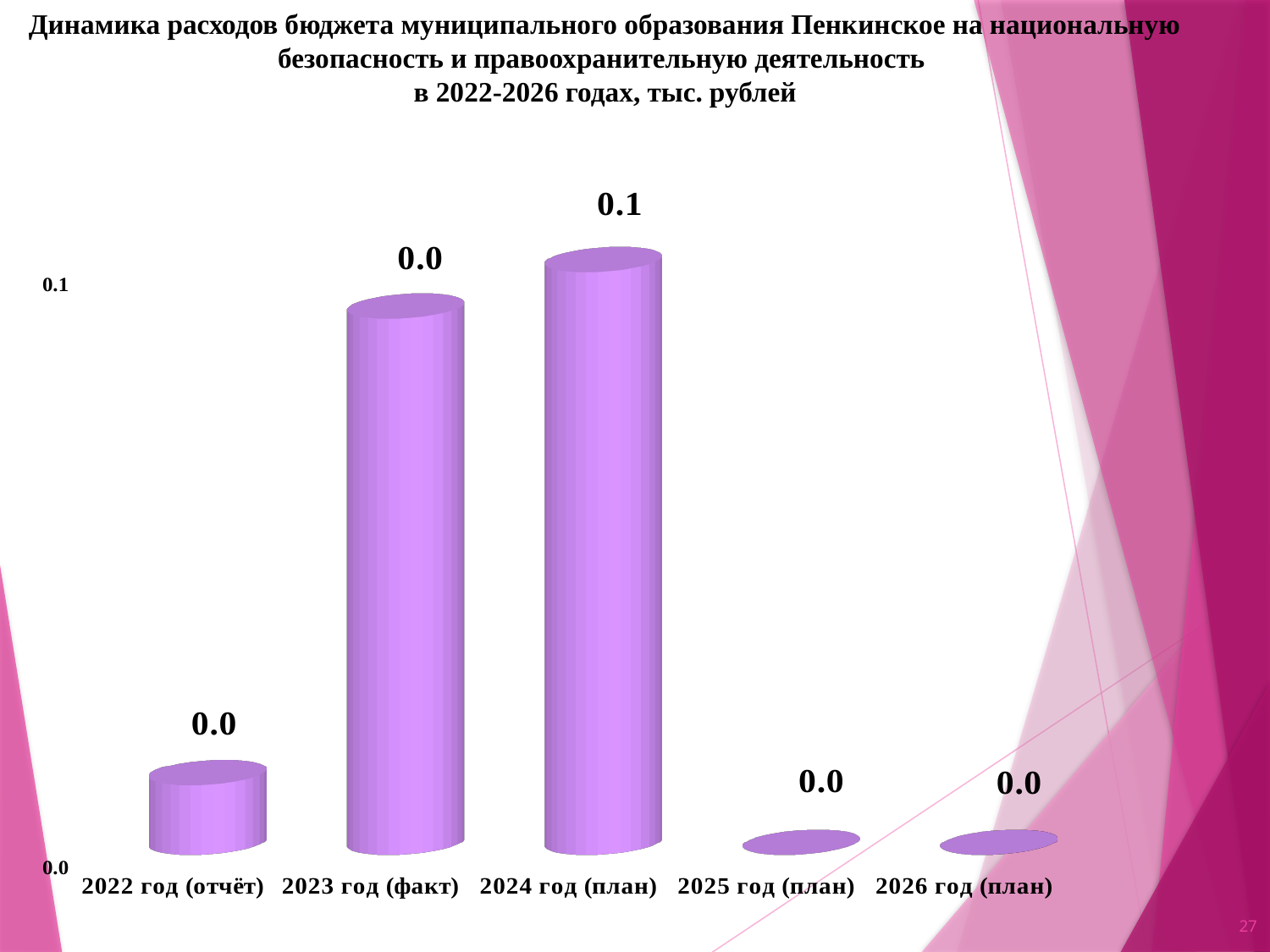
What value is shown for 2022 год (отчёт)? 0.0 What value is labelled on the bar for 2023 год (факт)? 0.0 Which year has the highest value on the chart? 2024 год (план) What value is shown for 2026 год (план)? 0.0 What kind of chart is shown on the slide? bar chart What value is shown for 2024 год (план)? 0.1 How many years (categories) are shown on the chart? 5 What value is shown for 2025 год (план)? 0.0 Does the value rise or fall from 2024 год (план) to 2025 год (план)? fall Which is larger, the value for 2024 год (план) or for 2022 год (отчёт)? 2024 год (план) Is the value for 2022 год (отчёт) greater or less than 0.1? less What is the difference between the labelled values for 2024 год (план) and 2022 год (отчёт)? 0.1